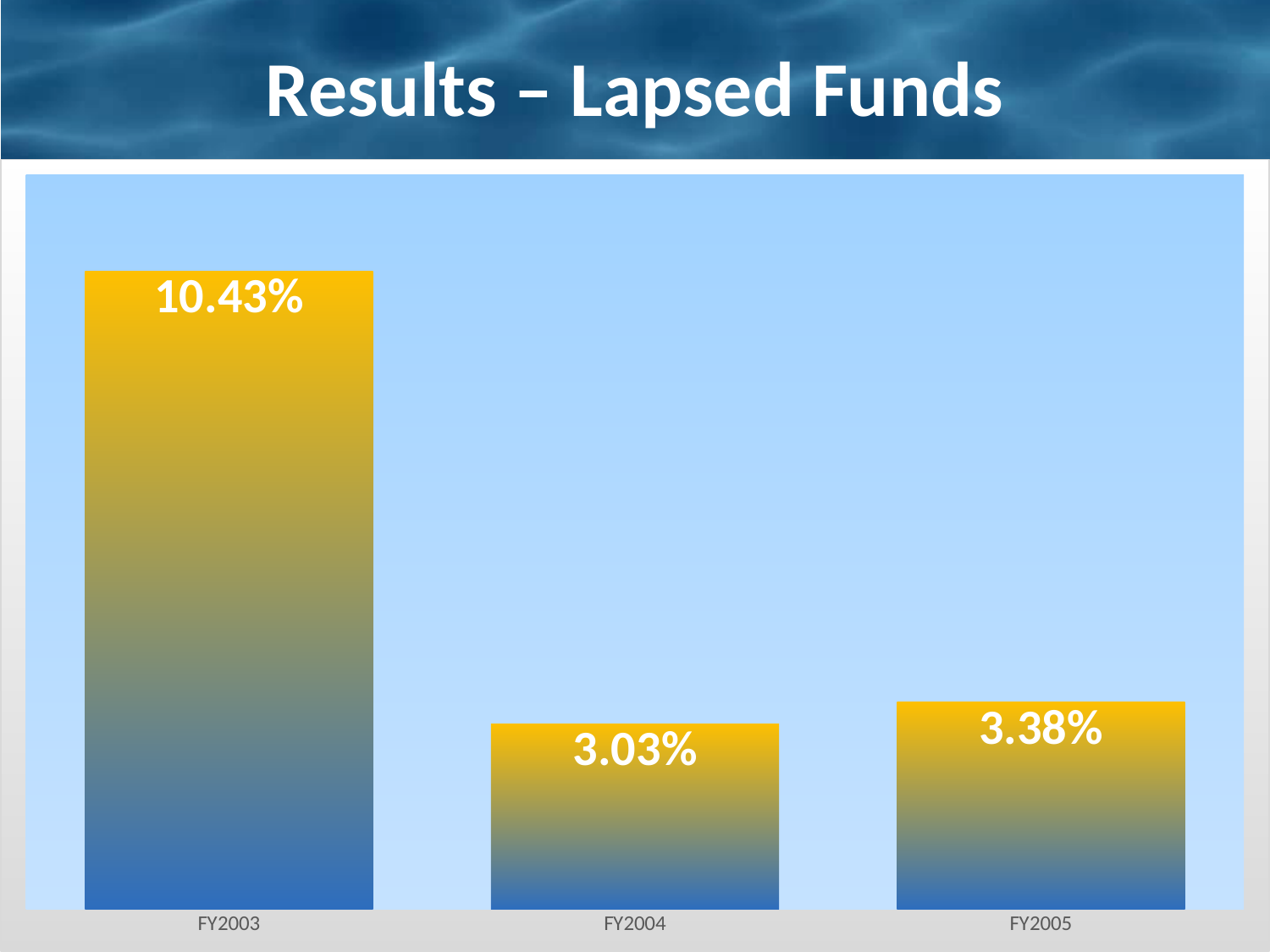
What is the value for FY2003? 10.43% Does the value rise or fall from FY2003 to FY2004? Fall Which is larger, the value for FY2004 or FY2005? FY2005 What is the difference between the values for FY2003 and FY2004? 7.40% What kind of chart is shown on the slide? Bar chart What is the value for FY2004? 3.03% Which fiscal year has the lowest value? FY2004 How many fiscal years are shown in the chart? 3 What is the difference between the values for FY2005 and FY2004? 0.35% What is the title of the slide? Results – Lapsed Funds What is the value for FY2005? 3.38% Which fiscal year has the highest value? FY2003